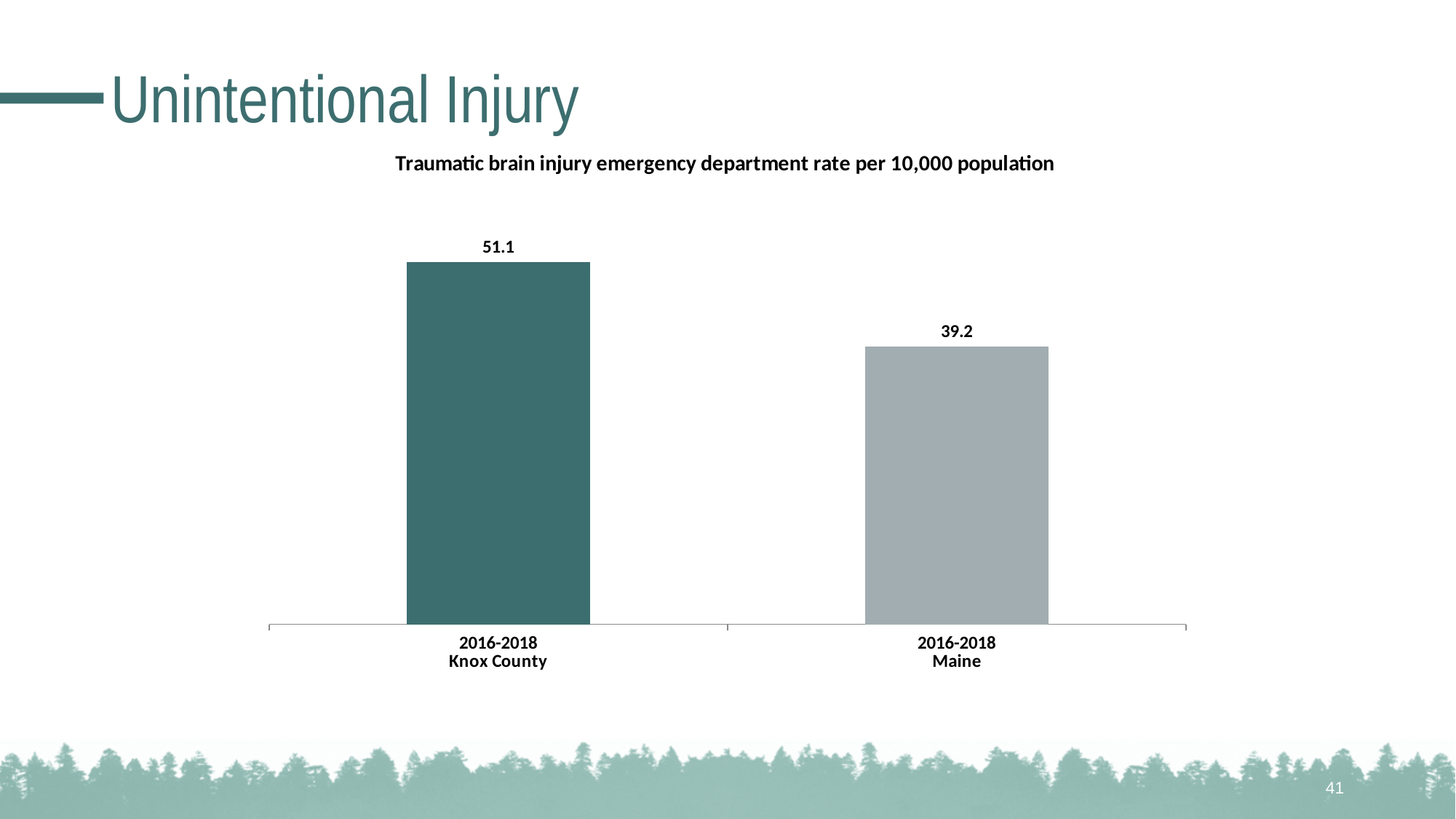
What is the difference between the Knox County rate and the Maine rate? 11.9 What kind of chart is shown on the slide? bar chart What time period do both bars on the chart cover? 2016-2018 Which category has the lowest traumatic brain injury emergency department rate on the chart? Maine Which category has the higher traumatic brain injury emergency department rate, Knox County or Maine? Knox County What is the title of the chart? Traumatic brain injury emergency department rate per 10,000 population How many bars are shown on the chart? 2 Is the Knox County rate larger or smaller than the Maine rate? larger What is the traumatic brain injury emergency department rate per 10,000 population for Knox County in 2016-2018? 51.1 What is the traumatic brain injury emergency department rate per 10,000 population for Maine in 2016-2018? 39.2